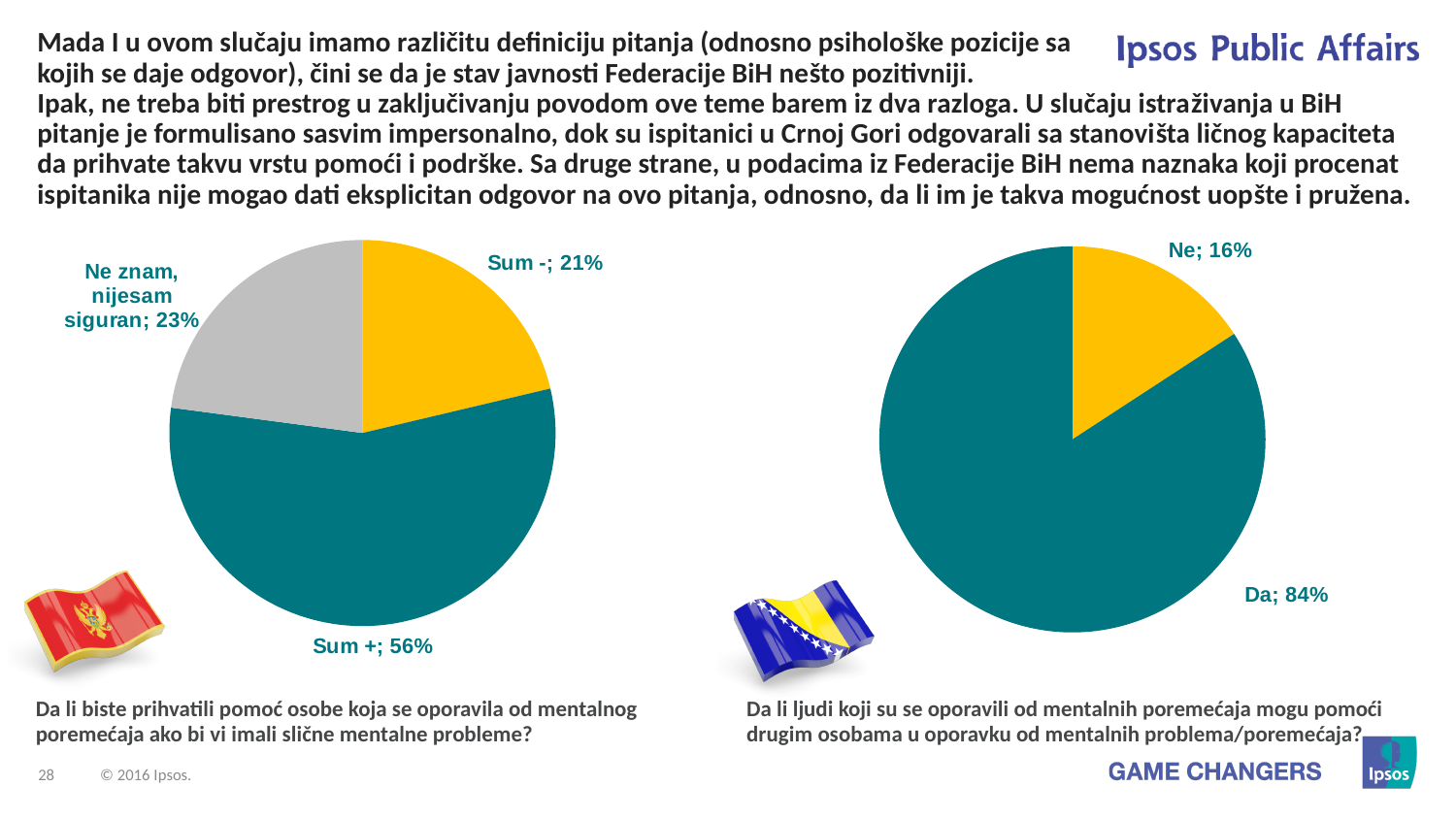
In the right pie chart, what is the value for "Da"? 84% In the left pie chart, which is larger: "Ne znam, nijesam siguran" or "Sum -"? Ne znam, nijesam siguran What type of chart is the right chart on the slide? Pie chart How many slices does the left pie chart have? 3 In the left pie chart, which category has the largest share? Sum + In the left pie chart, which category has the smallest share? Sum - In the right pie chart, what is the difference between the "Da" and "Ne" shares? 68% In the right pie chart, what is the value for "Ne"? 16% In the left pie chart, what is the difference between the "Sum +" and "Sum -" shares? 35% In the left pie chart, what is the value for "Ne znam, nijesam siguran"? 23% In the left pie chart, what is the value for "Sum -"? 21% In the left pie chart, what is the value for "Sum +"? 56%